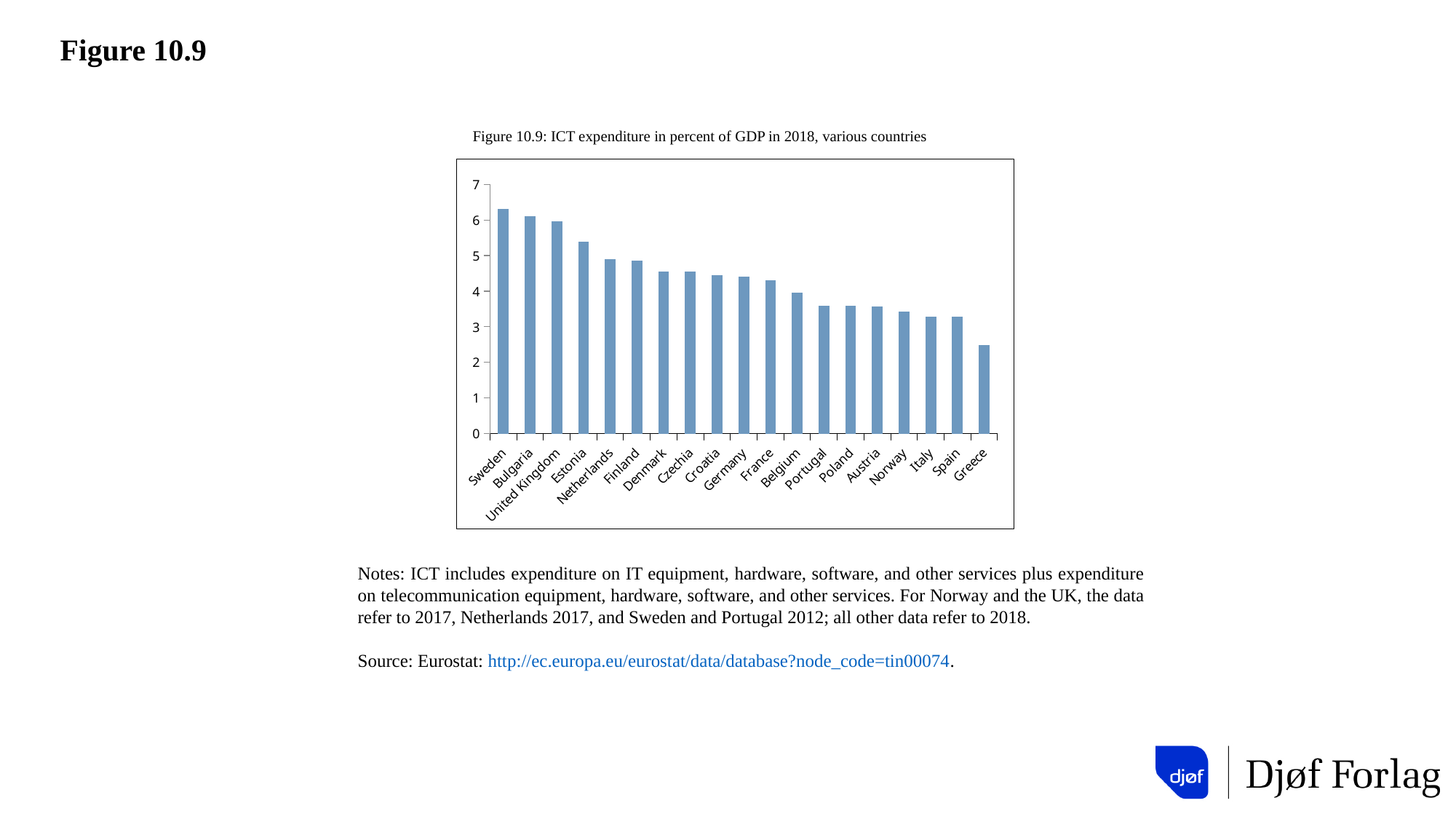
Is the value for Estonia greater or less than 5? greater Is the value for Greece greater or less than 3? less What kind of chart is shown on the slide? Bar chart Which country has the lowest ICT expenditure in percent of GDP? Greece Is the value for Italy greater or less than 3? greater What is the title of the chart? Figure 10.9: ICT expenditure in percent of GDP in 2018, various countries How many countries are shown in the chart? 19 Do the values rise or fall from left to right across the countries? Fall Which country has the highest ICT expenditure in percent of GDP? Sweden Which has a higher ICT expenditure in percent of GDP, Estonia or Denmark? Estonia